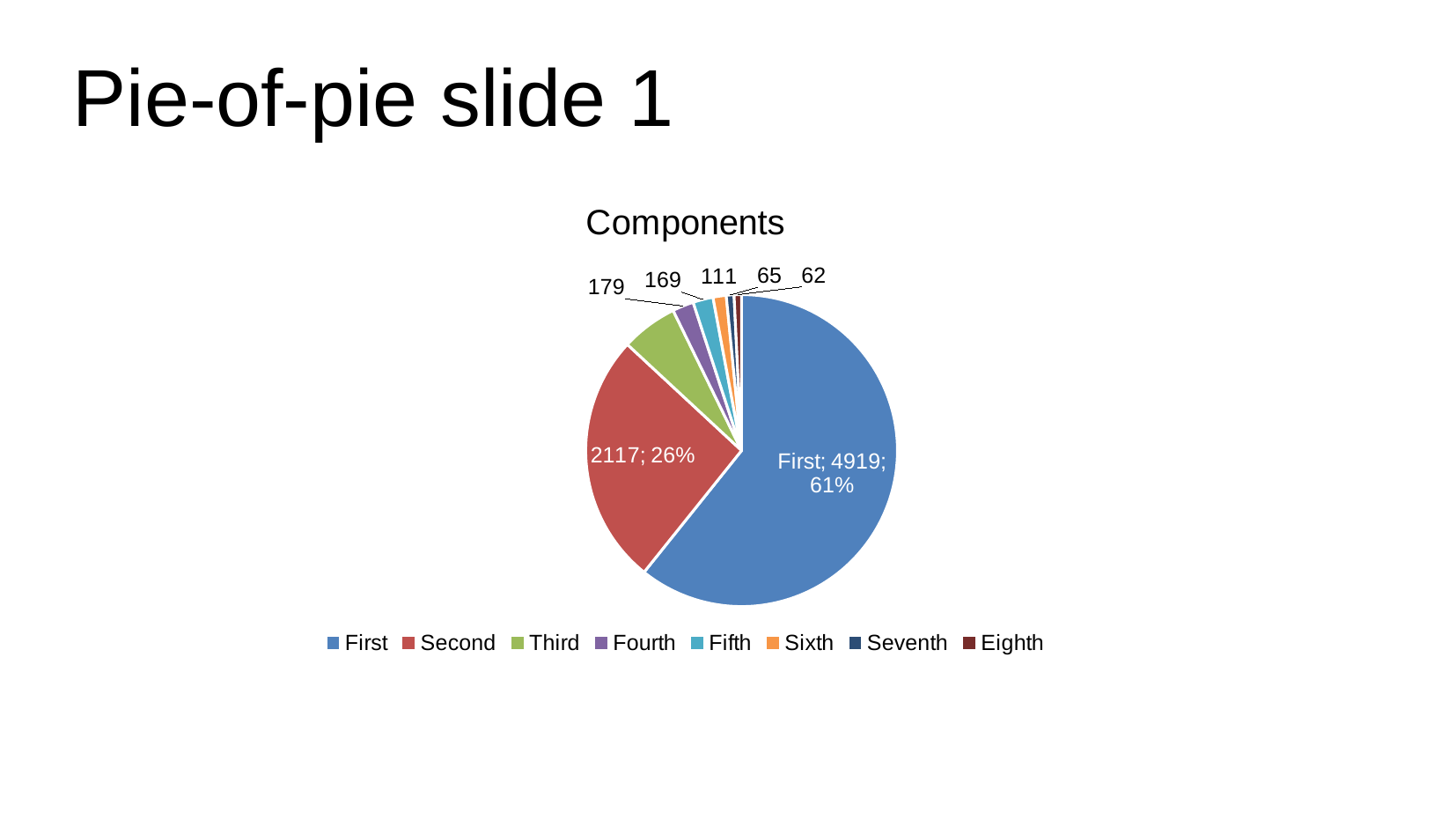
Which is larger, the First slice or the Second slice? First What is the difference between the First value and the Second value? 2802 What is the value of the Second slice? 2117 How many entries does the legend list? 8 Which slice is the largest? First What share of the pie does the Second slice represent? 26% What is the value of the First slice? 4919 What share of the pie does the First slice represent? 61% How many slices does the pie chart have? 8 What kind of chart is shown on the slide? pie chart What is the title of the chart? Components